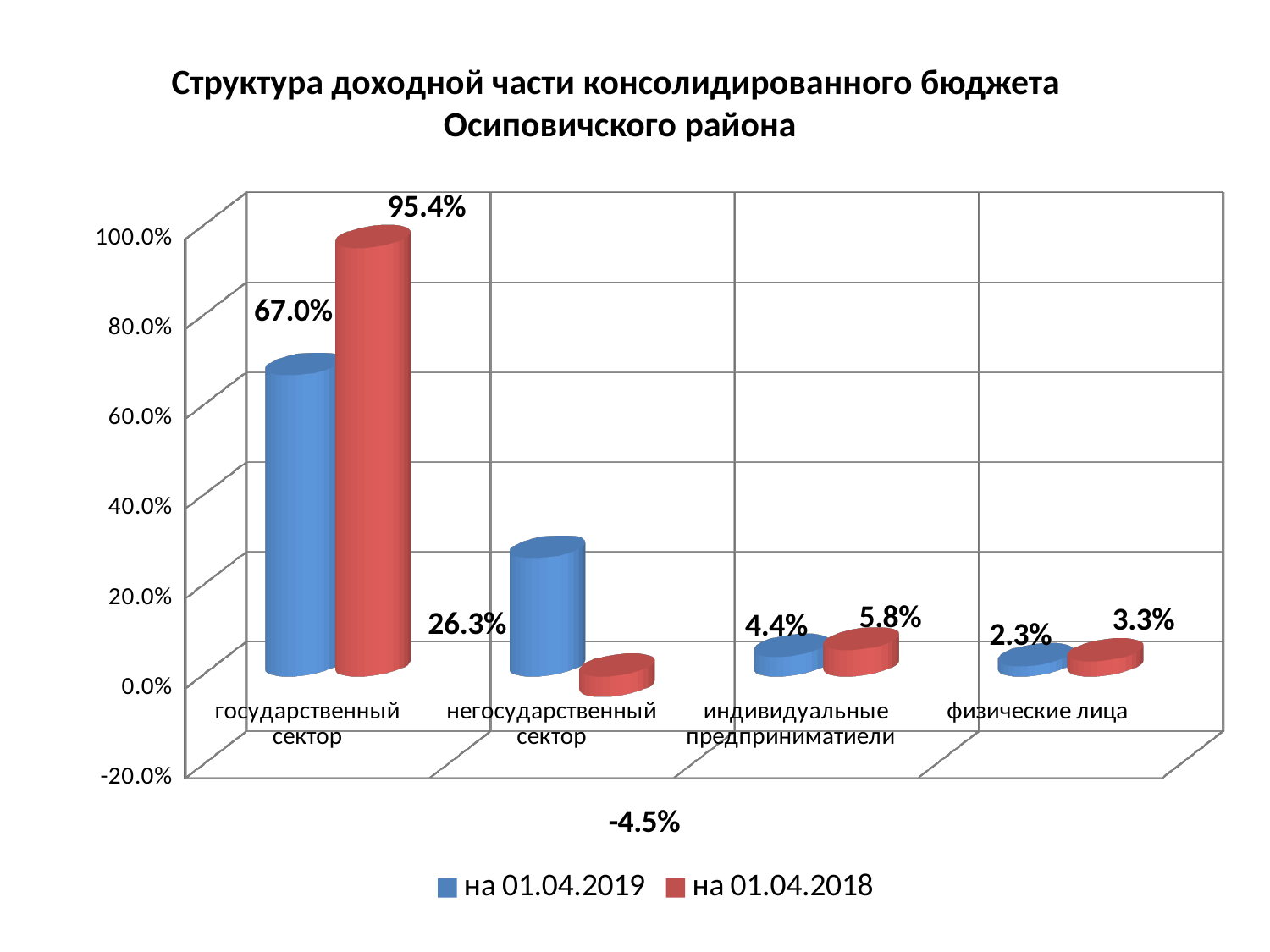
How many series does the legend list? 2 Which category has the lowest value in the series на 01.04.2018? негосударственный сектор What is the difference between the на 01.04.2018 and на 01.04.2019 values for государственный сектор? 28.4% What is the value for государственный сектор in the series на 01.04.2018? 95.4% How many categories are shown on the x axis? 4 Which colour represents the series на 01.04.2018? red What is the value for физические лица in the series на 01.04.2019? 2.3% Which is larger for индивидуальные предприниматели: the value for на 01.04.2019 or на 01.04.2018? на 01.04.2018 Which category has the highest value in the series на 01.04.2019? государственный сектор What is the value for государственный сектор in the series на 01.04.2019? 67.0% What kind of chart is shown on the slide? bar chart What is the value for негосударственный сектор in the series на 01.04.2018? -4.5%